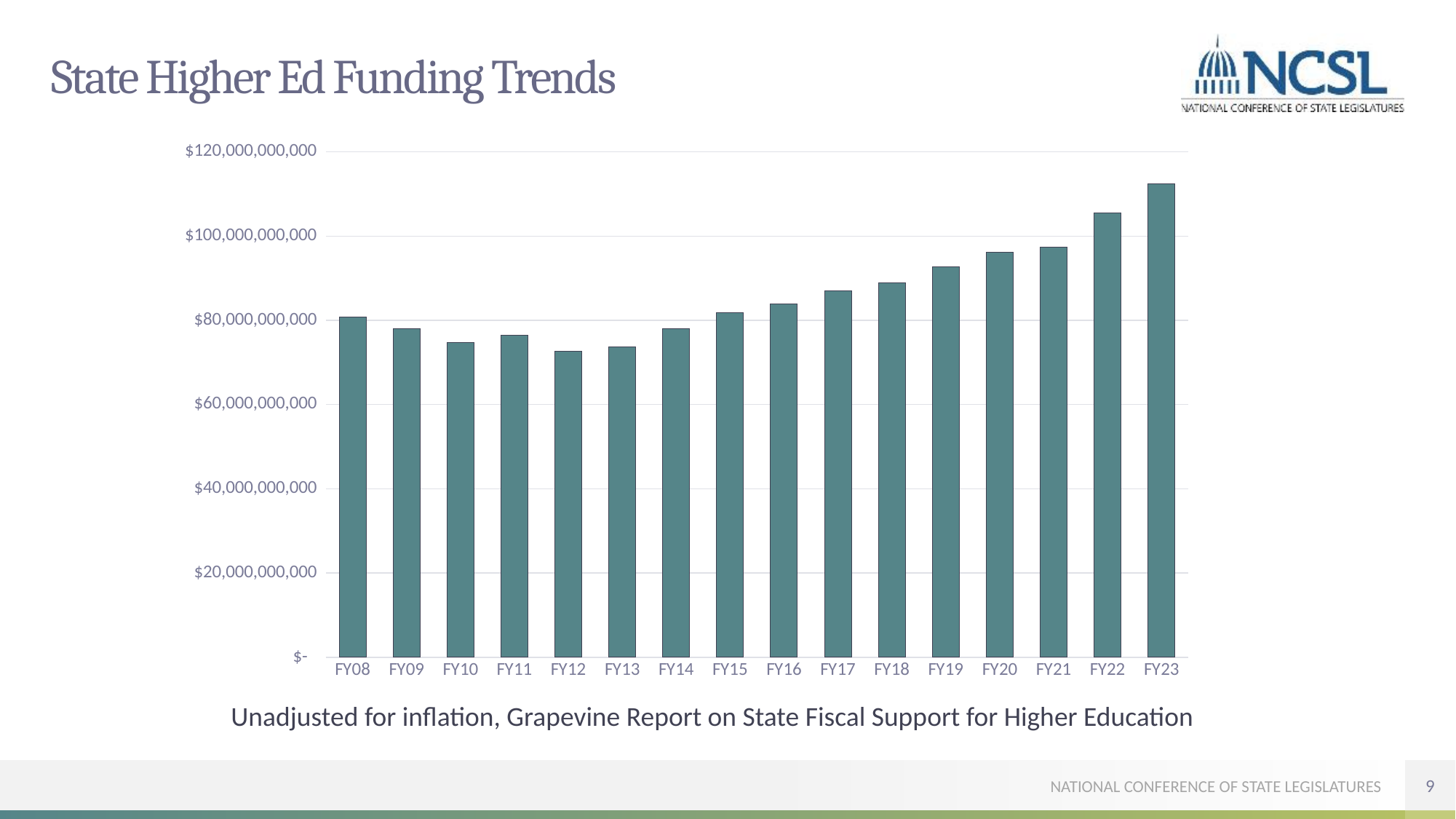
Is the value for FY23 greater or less than $100,000,000,000? greater Which is larger, the value for FY15 or the value for FY12? FY15 How many fiscal years are plotted on the x axis? 16 Is the value for FY12 greater or less than $80,000,000,000? less Which fiscal year has the highest value? FY23 Is the value for FY17 greater or less than $80,000,000,000? greater Which is larger, the value for FY08 or the value for FY14? FY08 What is the title of the chart on the slide? State Higher Ed Funding Trends What kind of chart is shown on the slide? Bar chart According to the caption below the chart, what report is the data from? Grapevine Report on State Fiscal Support for Higher Education Do the values rise or fall from FY12 to FY23? Rise